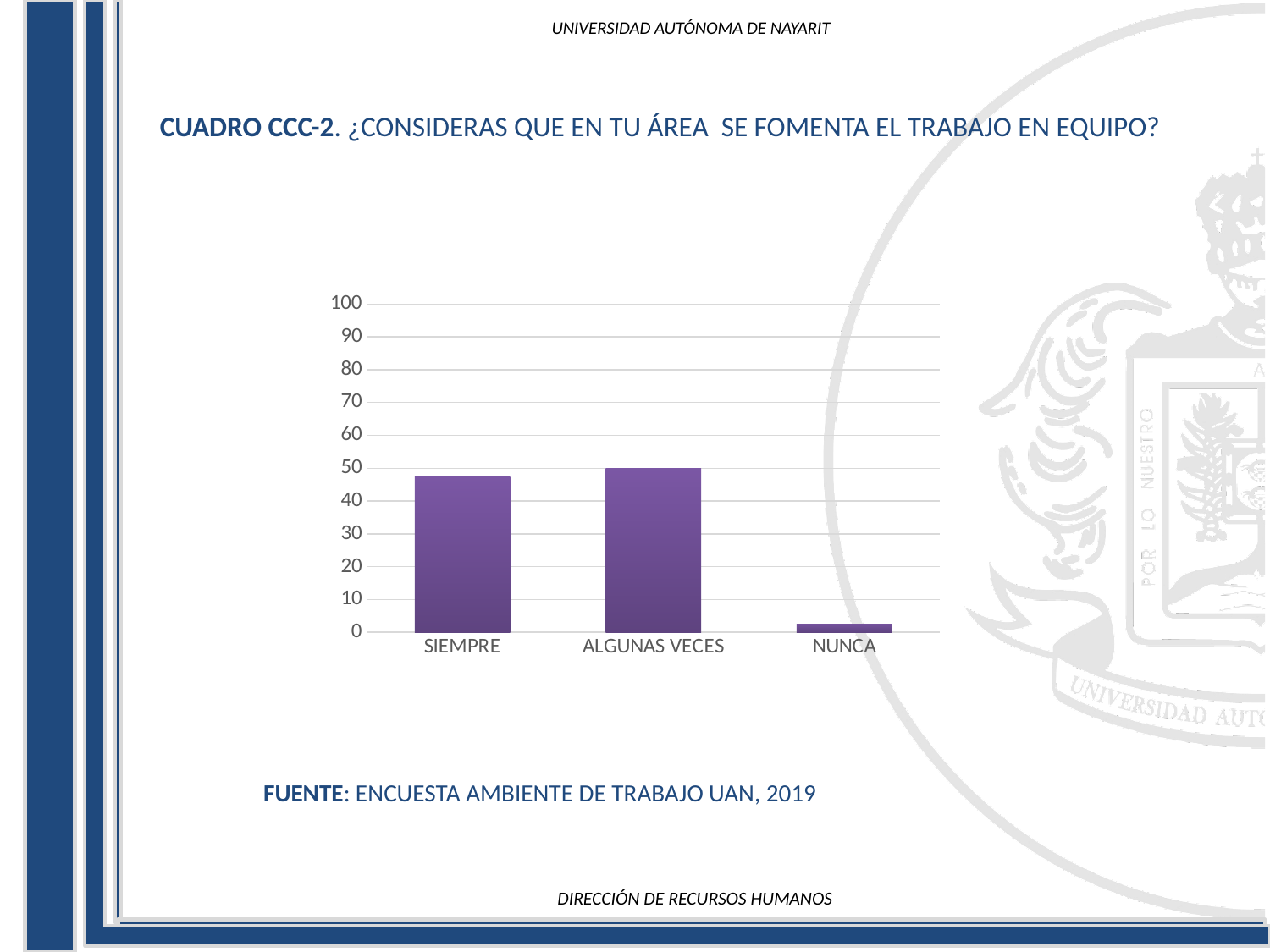
What kind of chart is shown on the slide? bar chart What question does the chart title (CUADRO CCC-2) ask? ¿CONSIDERAS QUE EN TU ÁREA SE FOMENTA EL TRABAJO EN EQUIPO? What is the highest value shown on the y axis of the chart? 100 Which is larger, the value for SIEMPRE or the value for NUNCA? SIEMPRE Is the value for NUNCA greater or less than 10? less Is the value for SIEMPRE greater or less than 50? less What is the value for ALGUNAS VECES? 50 How many categories are shown on the x axis of the chart? 3 Which category has the lowest value in the chart? NUNCA Is the value for SIEMPRE greater or less than 40? greater Which is larger, the value for ALGUNAS VECES or the value for NUNCA? ALGUNAS VECES